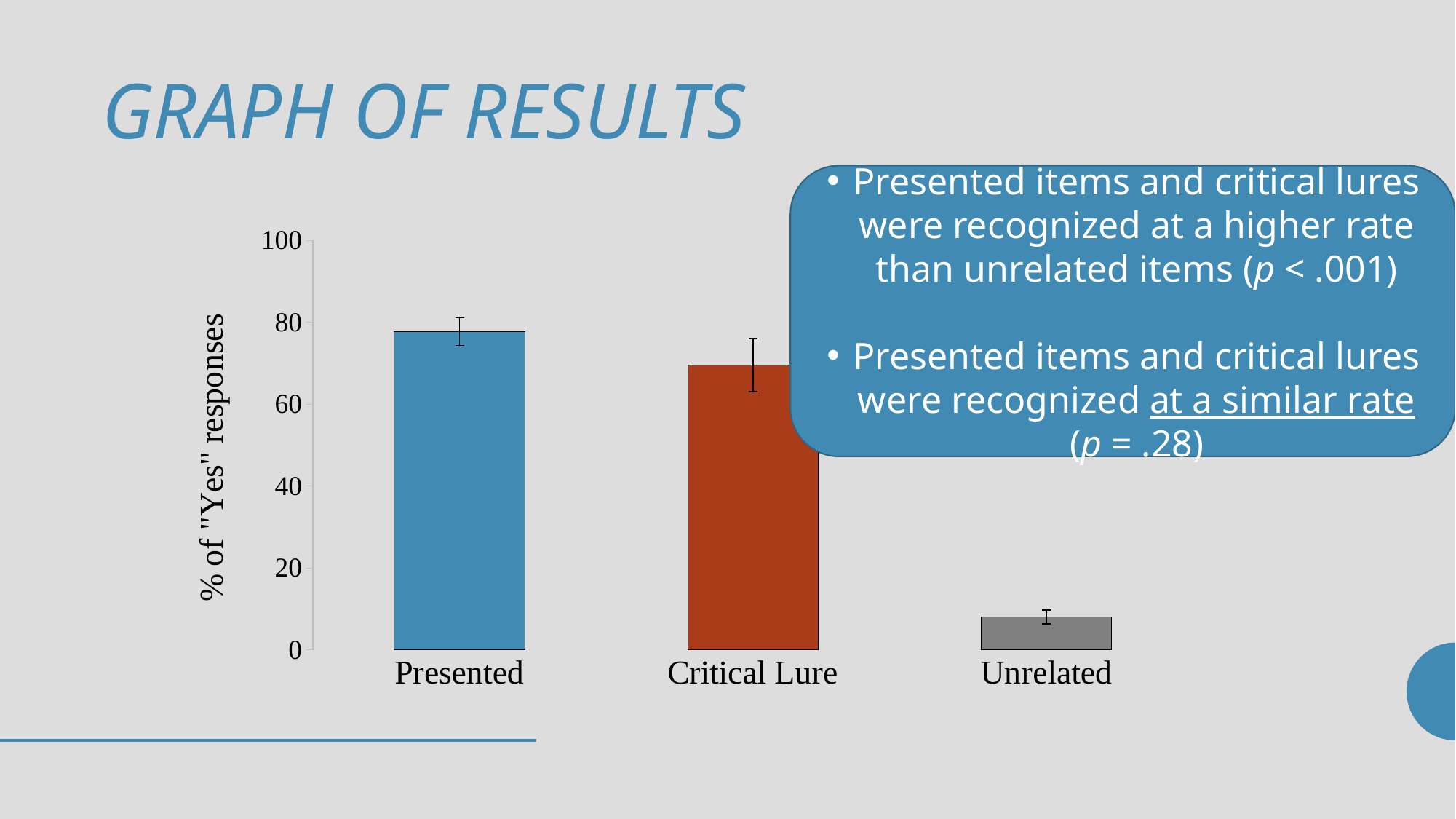
What is the label on the y axis of the chart? % of "Yes" responses Which category has the highest percentage of "Yes" responses? Presented What kind of chart is shown on the slide? bar chart Which is larger, the value for Critical Lure or the value for Unrelated? Critical Lure Is the value for Critical Lure greater or less than 60? greater Which category has the lowest percentage of "Yes" responses? Unrelated Is the value for Presented greater or less than 60? greater How many categories are shown on the x axis of the chart? 3 What colour is the bar for Critical Lure? red Is the value for Critical Lure greater or less than 80? less Do the bar values rise or fall from left to right across the x axis? fall